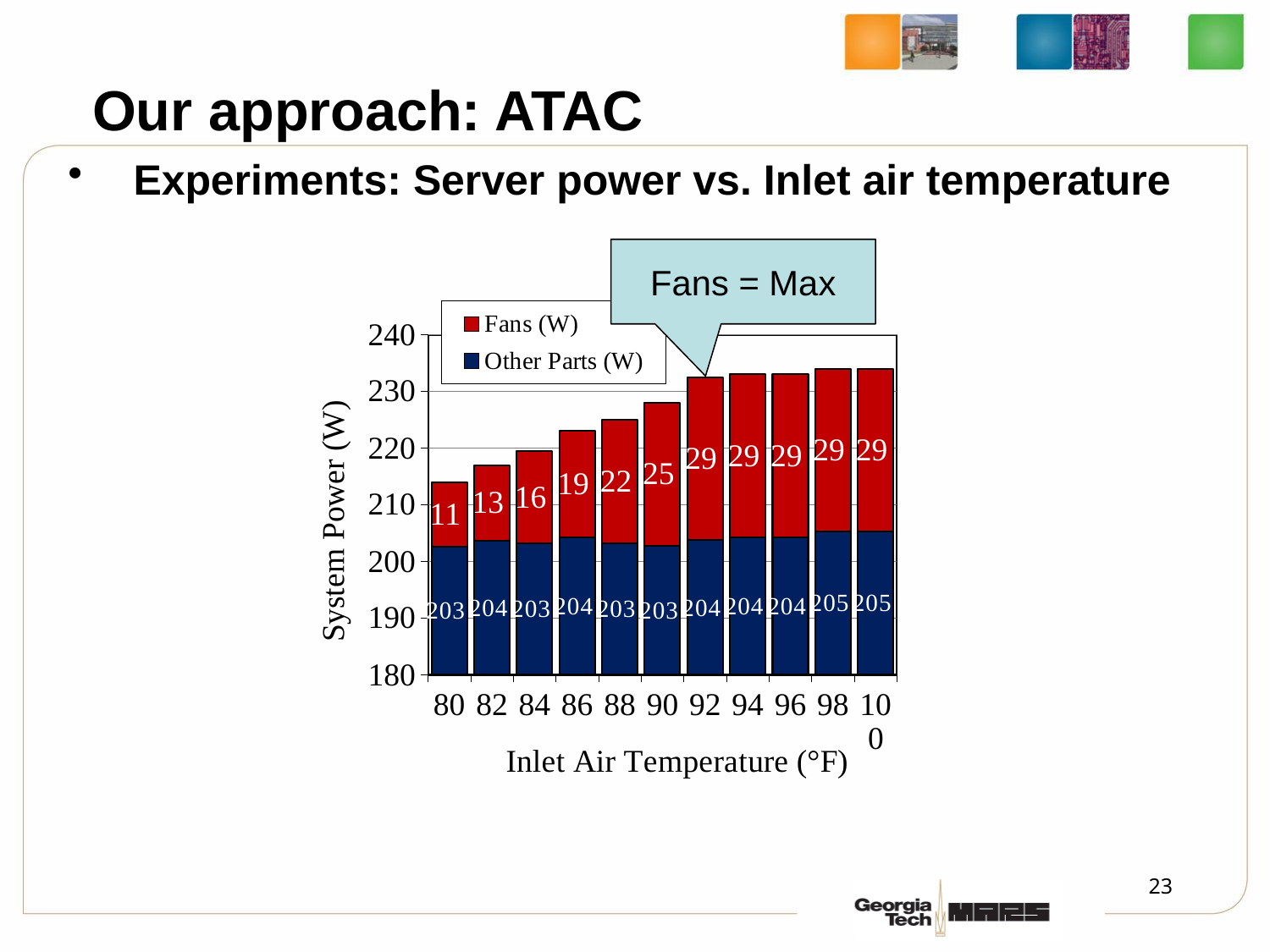
What is the total system power (Fans plus Other Parts) at an inlet air temperature of 100°F? 234 What is the difference between the Fans (W) value at 92°F and at 80°F? 18 What is the Fans (W) value at an inlet air temperature of 80°F? 11 What type of chart is shown on the slide? stacked bar chart Which is larger, the Fans (W) value at 86°F or at 90°F? 90°F What is the Other Parts (W) value at an inlet air temperature of 98°F? 205 What does the callout above the chart say? Fans = Max How many series does the legend list? 2 What is the Fans (W) value at an inlet air temperature of 88°F? 22 How many inlet air temperature categories are plotted on the x axis? 11 At which inlet air temperature is the Fans (W) value lowest? 80 Does the Fans (W) value rise or fall as inlet air temperature increases from 80°F to 92°F? rise